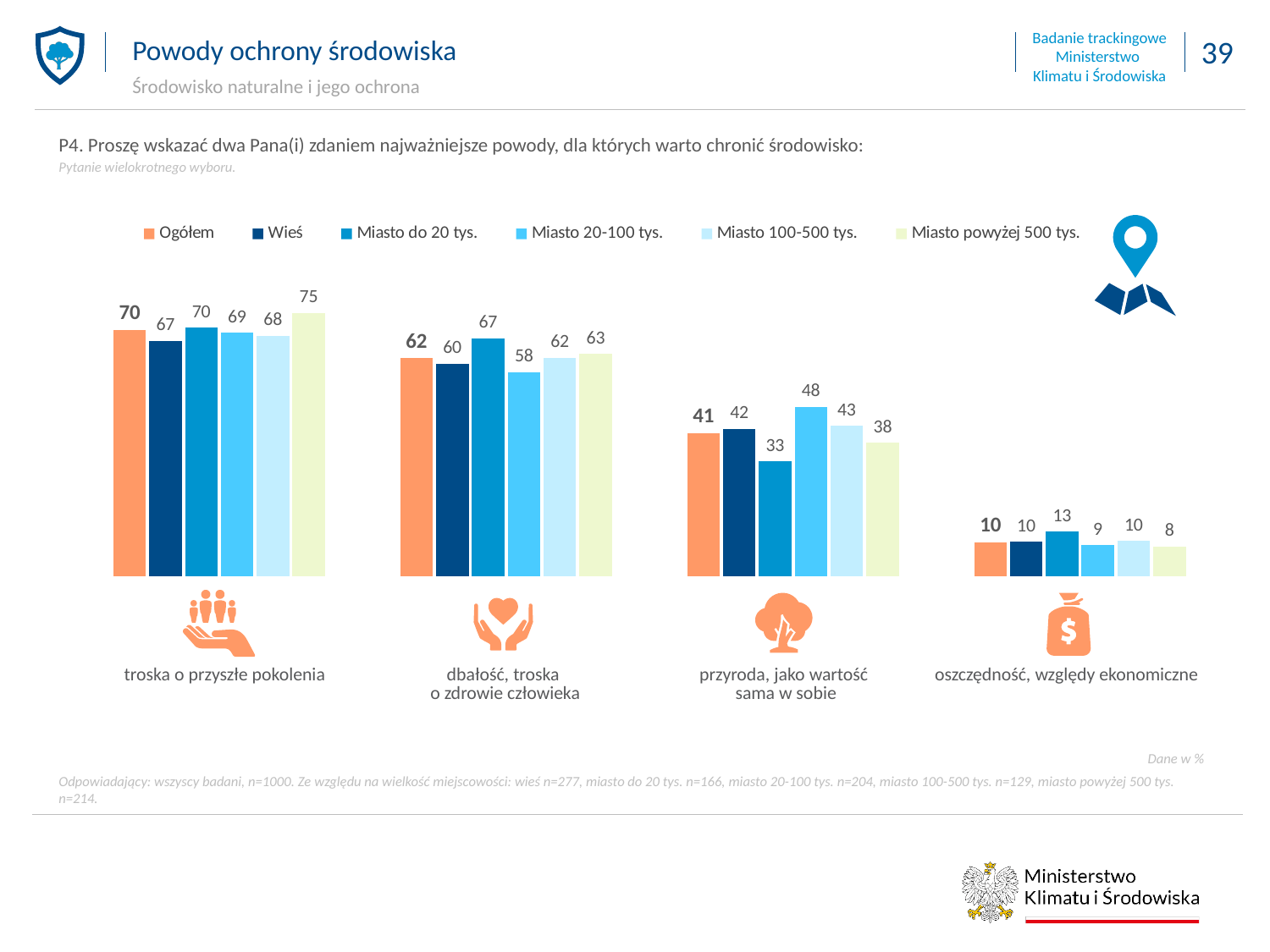
What is the value for Miasto powyżej 500 tys. in the category "oszczędność, względy ekonomiczne"? 8 How many series does the legend list? 6 Which series is shown in orange in the legend? Ogółem What is the value for Miasto do 20 tys. in the category "przyroda, jako wartość sama w sobie"? 33 Which category has the lowest Ogółem value? oszczędność, względy ekonomiczne What kind of chart is shown on the slide? bar chart How many categories are shown on the chart? 4 What is the value for Ogółem in the category "troska o przyszłe pokolenia"? 70 Which series has the lowest value in the category "dbałość, troska o zdrowie człowieka"? Miasto 20-100 tys. Which series has the highest value in the category "troska o przyszłe pokolenia"? Miasto powyżej 500 tys. What is the difference between the Miasto 20-100 tys. value and the Miasto do 20 tys. value in the category "przyroda, jako wartość sama w sobie"? 15 Which is larger in the category "dbałość, troska o zdrowie człowieka": the value for Wieś or the value for Miasto do 20 tys.? Miasto do 20 tys.